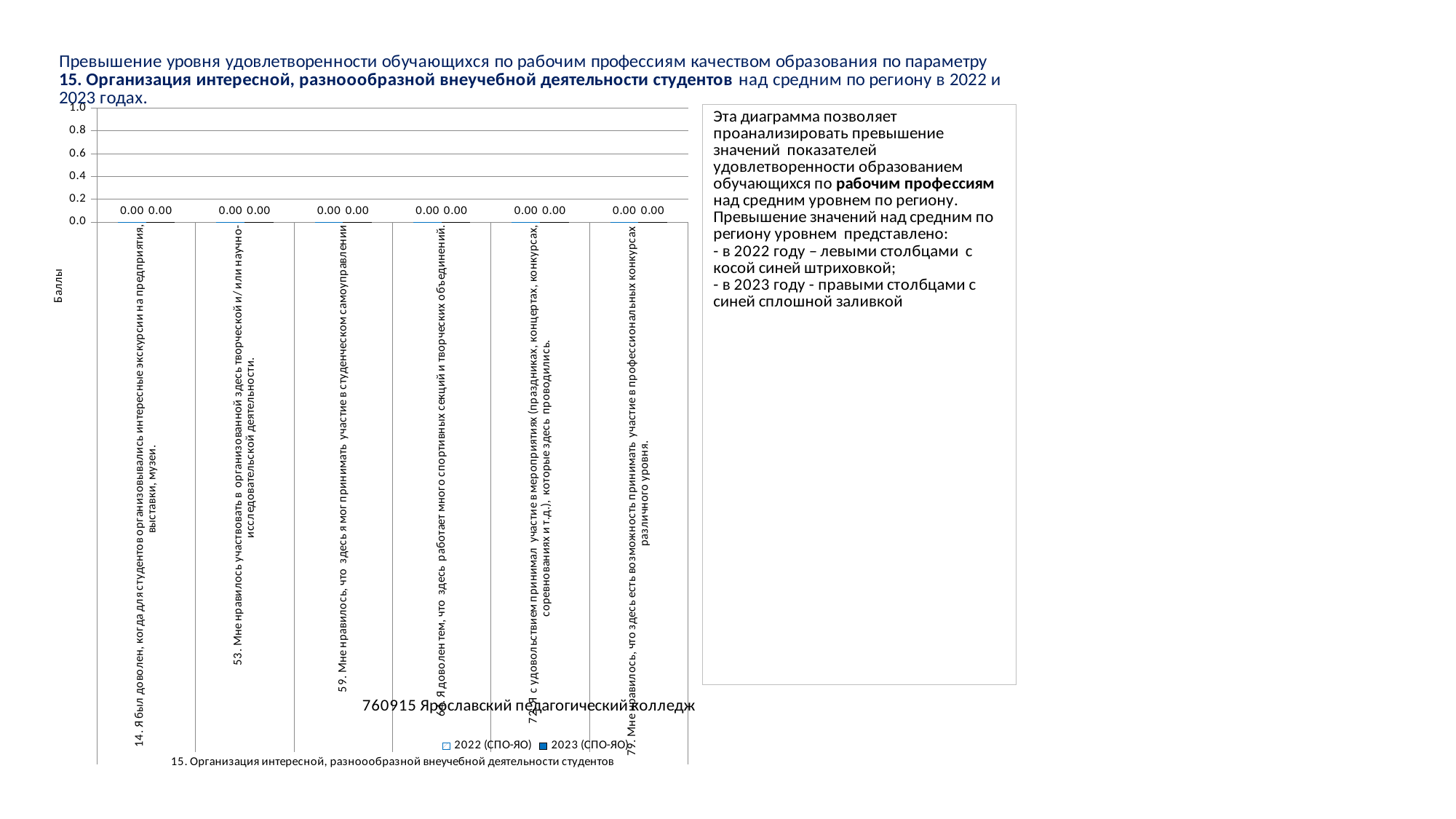
What is the 2023 (СПО-ЯО) value for category 59 (participation in student self-government)? 0.00 What is the 2022 (СПО-ЯО) value for category 14 (excursions to enterprises, exhibitions, museums)? 0.00 How many categories are shown on the x axis of the chart? 6 What is the 2023 (СПО-ЯО) value for category 79 (participation in professional competitions of various levels)? 0.00 What kind of chart is shown on the slide? Bar chart What is the highest value shown on the vertical axis of the chart? 1.0 What are the two series names listed in the chart legend? 2022 (СПО-ЯО) and 2023 (СПО-ЯО) How many series does the chart legend list? 2 What is the difference between the 2022 (СПО-ЯО) and 2023 (СПО-ЯО) values for category 53 (creative and/or research activity)? 0.00 What is the 2022 (СПО-ЯО) value for category 72 (participation in events such as holidays, concerts, competitions)? 0.00 Is the 2023 (СПО-ЯО) value for category 14 greater or less than 0.2? less What is the title of the vertical axis of the chart? Баллы